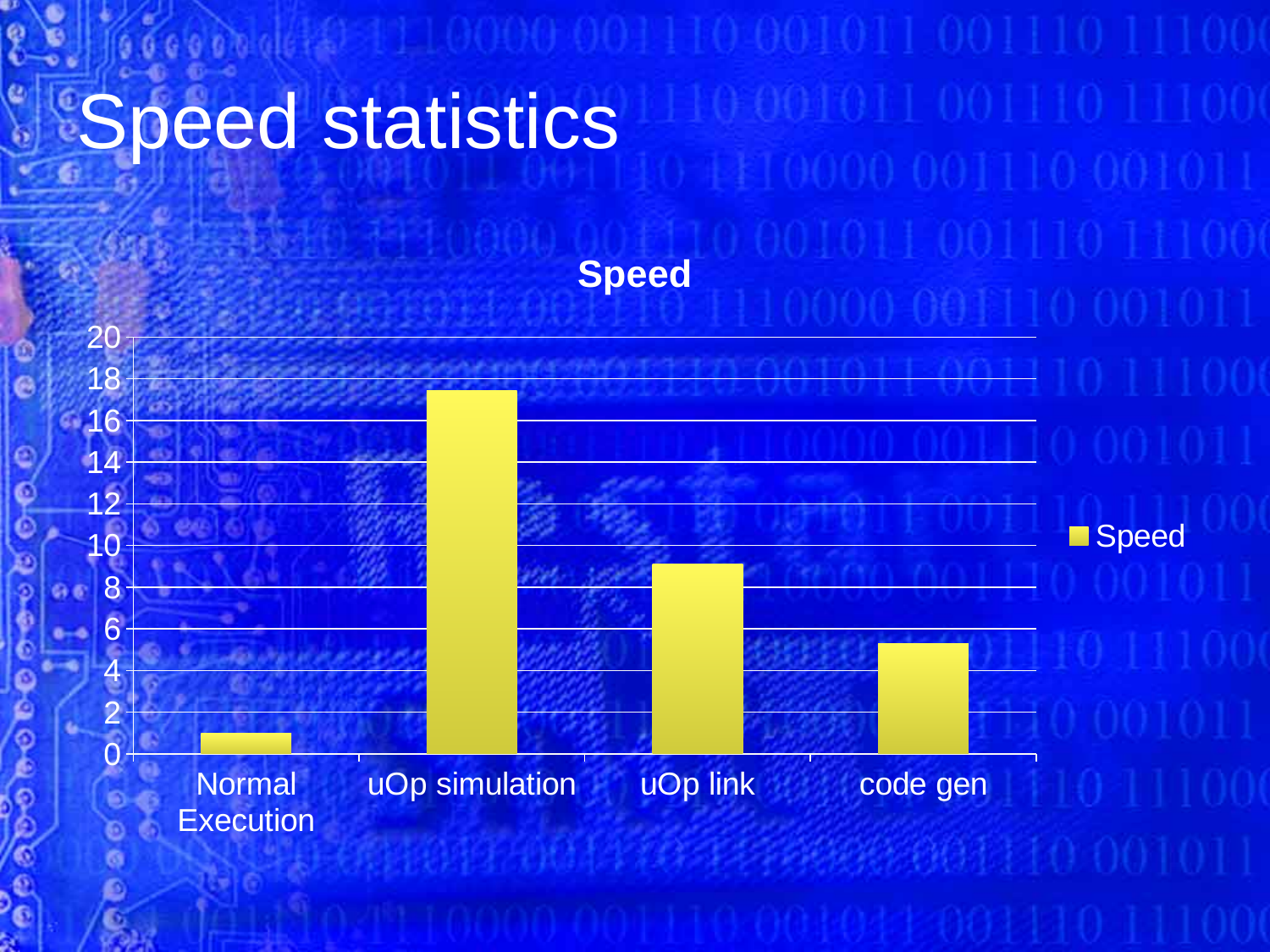
Which category has the lowest value? Normal Execution How many categories are shown on the x axis of the chart? 4 How many series does the legend list? 1 What is the title of the chart? Speed Is the value for Normal Execution greater or less than 2? less Is the value for uOp simulation greater or less than 16? greater Is the value for uOp link greater or less than 10? less What type of chart is shown on the slide? bar chart Which category has the highest value? uOp simulation What is the name of the series shown in the legend? Speed Which is larger, the value for uOp link or the value for code gen? uOp link